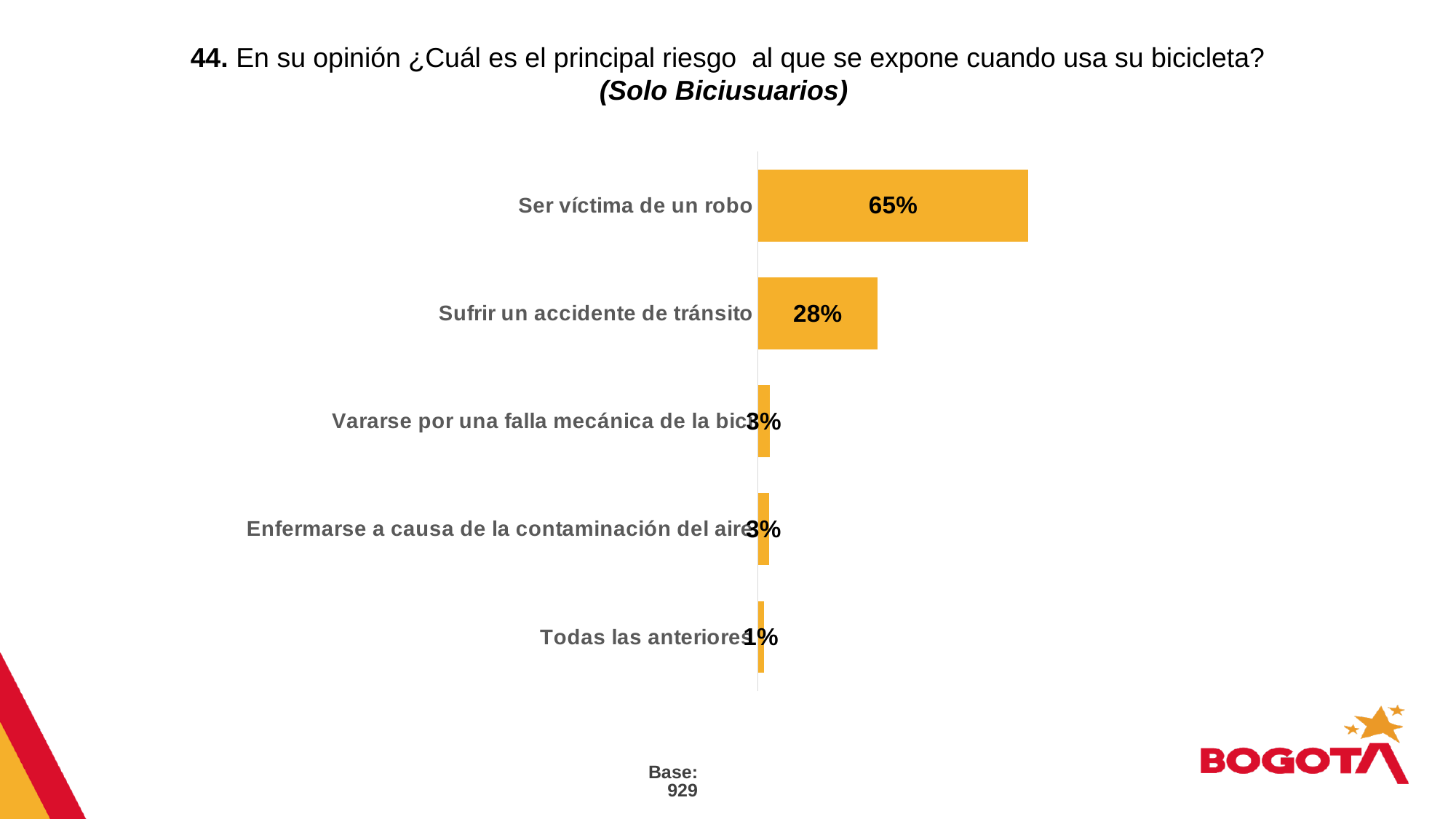
Which is larger: the value for "Sufrir un accidente de tránsito" or the value for "Todas las anteriores"? Sufrir un accidente de tránsito Which category has the highest value? Ser víctima de un robo What kind of chart is shown on the slide? Bar chart What colour are the bars in the chart? Orange What percentage of respondents chose "Ser víctima de un robo" as the main risk? 65% What is the value shown for "Todas las anteriores"? 1% What is the value shown for "Enfermarse a causa de la contaminación del aire"? 3% What is the value shown for "Sufrir un accidente de tránsito"? 28% How many categories are shown in the chart? 5 What is the difference between the values for "Ser víctima de un robo" and "Sufrir un accidente de tránsito"? 37% What is the base (number of respondents) shown below the chart? 929 Which category has the lowest value? Todas las anteriores